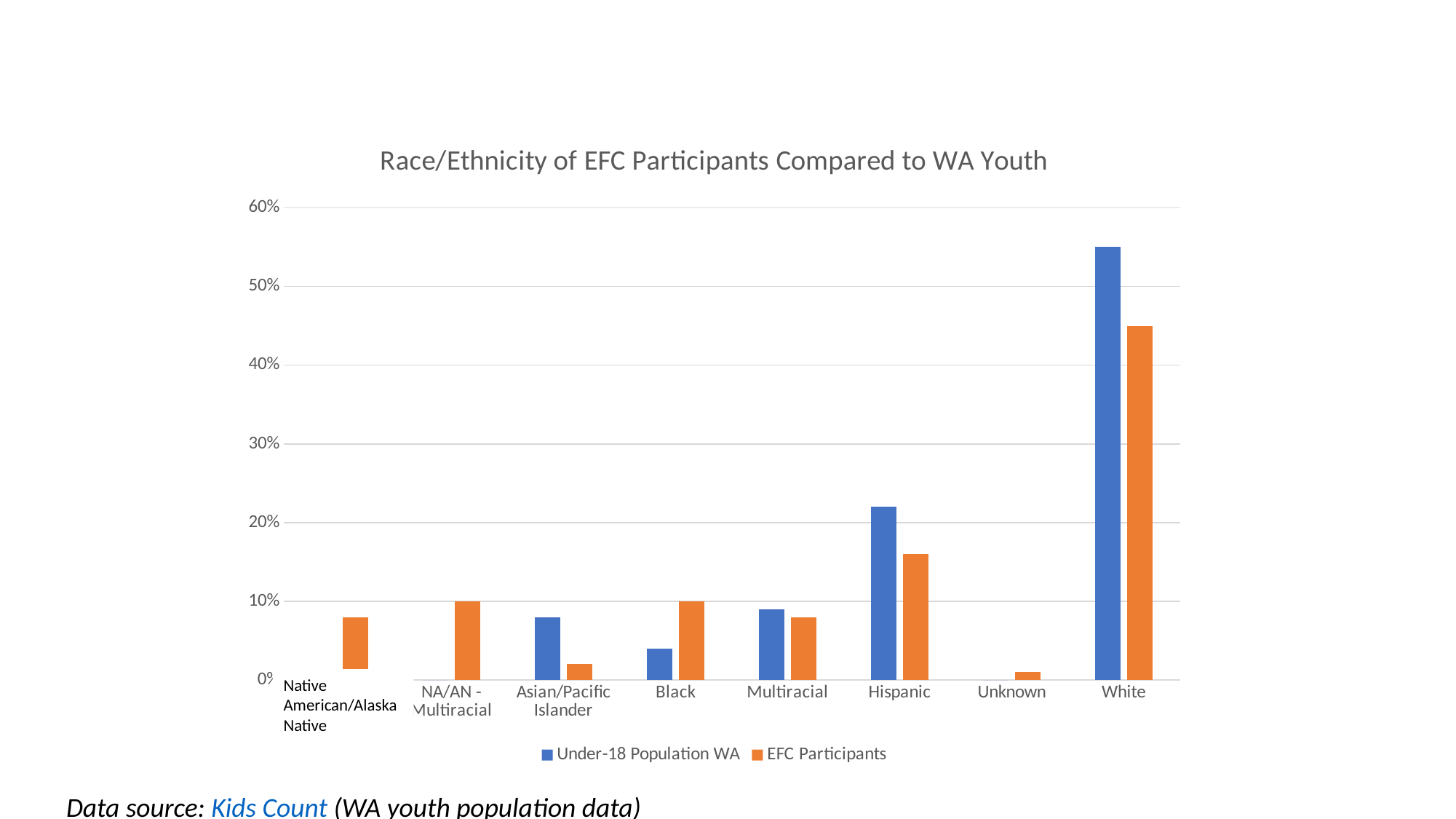
For Hispanic, which series has the larger value: Under-18 Population WA or EFC Participants? Under-18 Population WA Is the EFC Participants value for White greater or less than 50%? less What type of chart is shown on the slide? Bar chart Which category has the lowest value for EFC Participants? Unknown Is the Under-18 Population WA value for Hispanic greater or less than 20%? greater Is the Under-18 Population WA value for White greater or less than 50%? greater Which category has the highest value for EFC Participants? White What is the title of the chart? Race/Ethnicity of EFC Participants Compared to WA Youth How many race/ethnicity categories are shown on the x axis? 8 For Black, which series has the larger value: Under-18 Population WA or EFC Participants? EFC Participants Which category has the highest value for Under-18 Population WA? White How many series does the legend list? 2